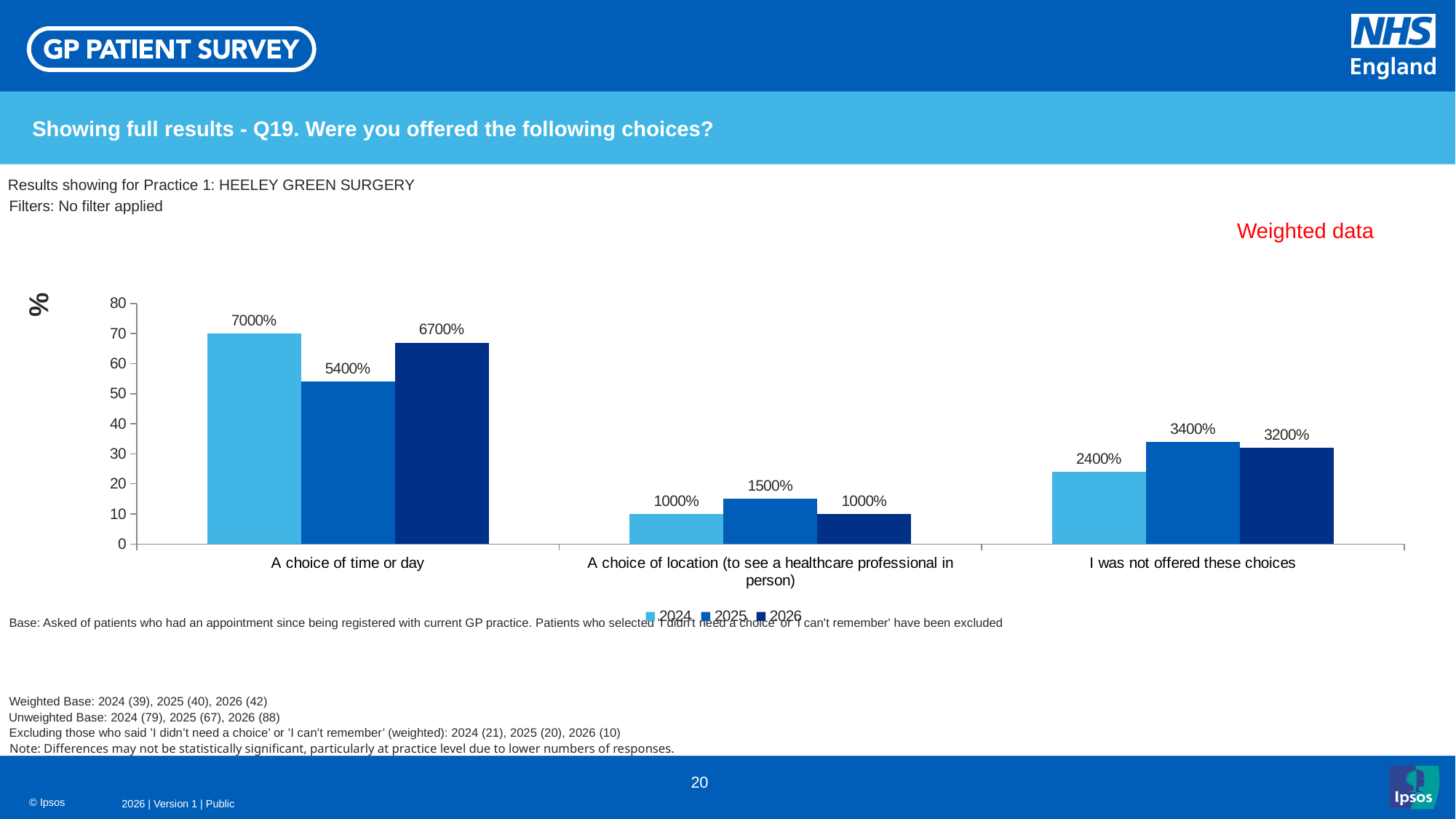
How many categories are shown on the x axis? 3 Which category has the lowest value for the 2025 series? A choice of location (to see a healthcare professional in person) What is the data label for 2024 in the 'A choice of time or day' category? 7000% In the 'I was not offered these choices' category, which series has the larger value, 2025 or 2026? 2025 What kind of chart is shown on the slide? Bar chart What are the legend entries of the chart? 2024, 2025, 2026 Which category has the highest value for the 2024 series? A choice of time or day What is the data label for 2025 in the 'I was not offered these choices' category? 3400% Is the 2026 bar for 'A choice of time or day' greater or less than 60 on the axis? greater How many series does the legend list? 3 What is the difference between the 2024 and 2025 data labels in the 'A choice of time or day' category? 1600% What is the data label for 2026 in the 'A choice of location (to see a healthcare professional in person)' category? 1000%